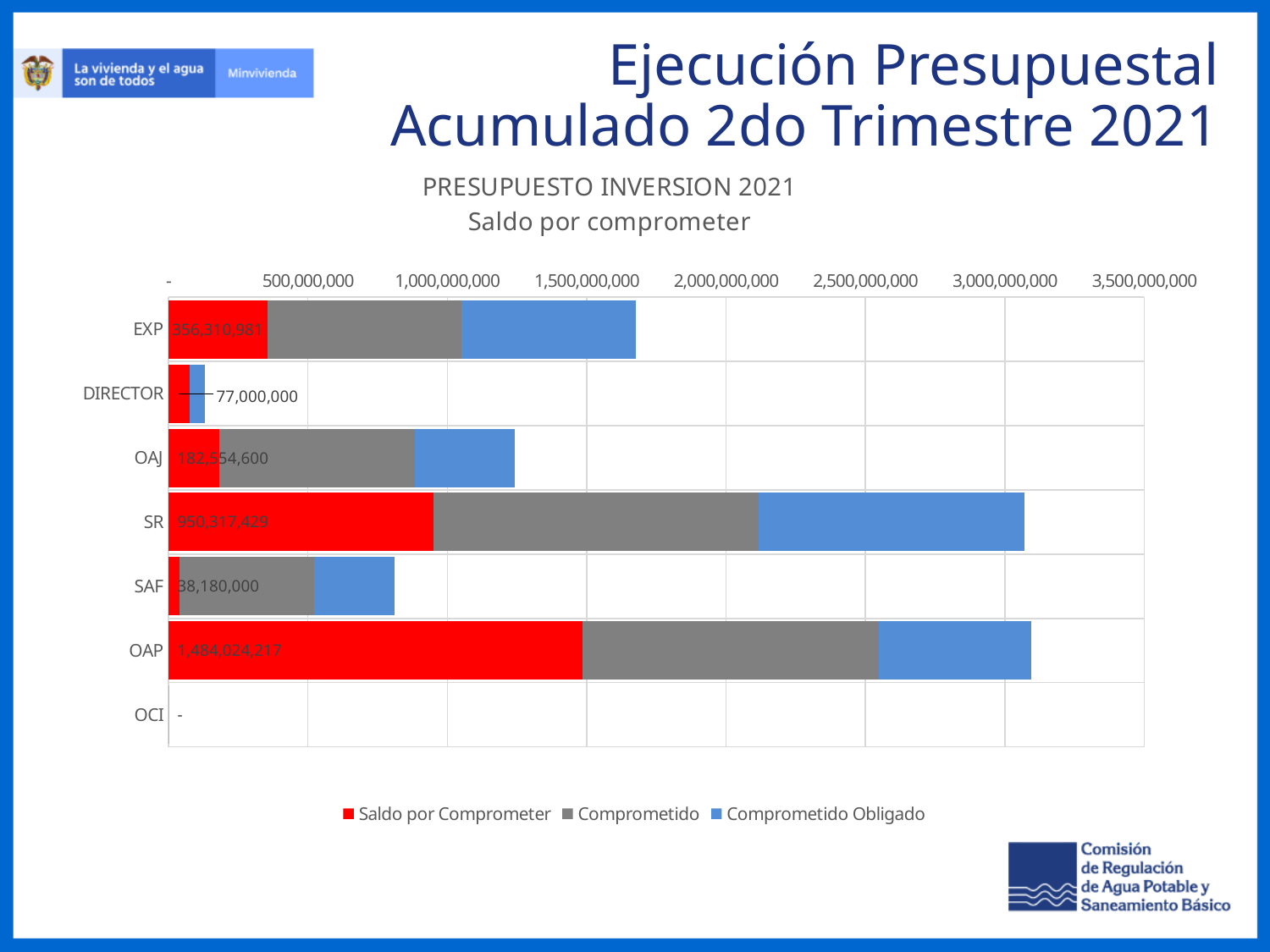
Which has a larger Saldo por Comprometer value, EXP or OAJ? EXP Excluding OCI, which category has the lowest Saldo por Comprometer value? SAF Is the total stacked bar length for EXP greater or less than 1,500,000,000? greater How many series does the legend list? 3 What is the difference between the Saldo por Comprometer values of OAP and SR? 533,706,788 What type of chart is shown on the slide? Stacked bar chart What is the Saldo por Comprometer value for OAP? 1,484,024,217 What is the Saldo por Comprometer value for SR? 950,317,429 What is the Saldo por Comprometer value for SAF? 38,180,000 Which category has the highest Saldo por Comprometer value? OAP What is the Saldo por Comprometer value for DIRECTOR? 77,000,000 How many categories are shown on the vertical axis of the chart? 7